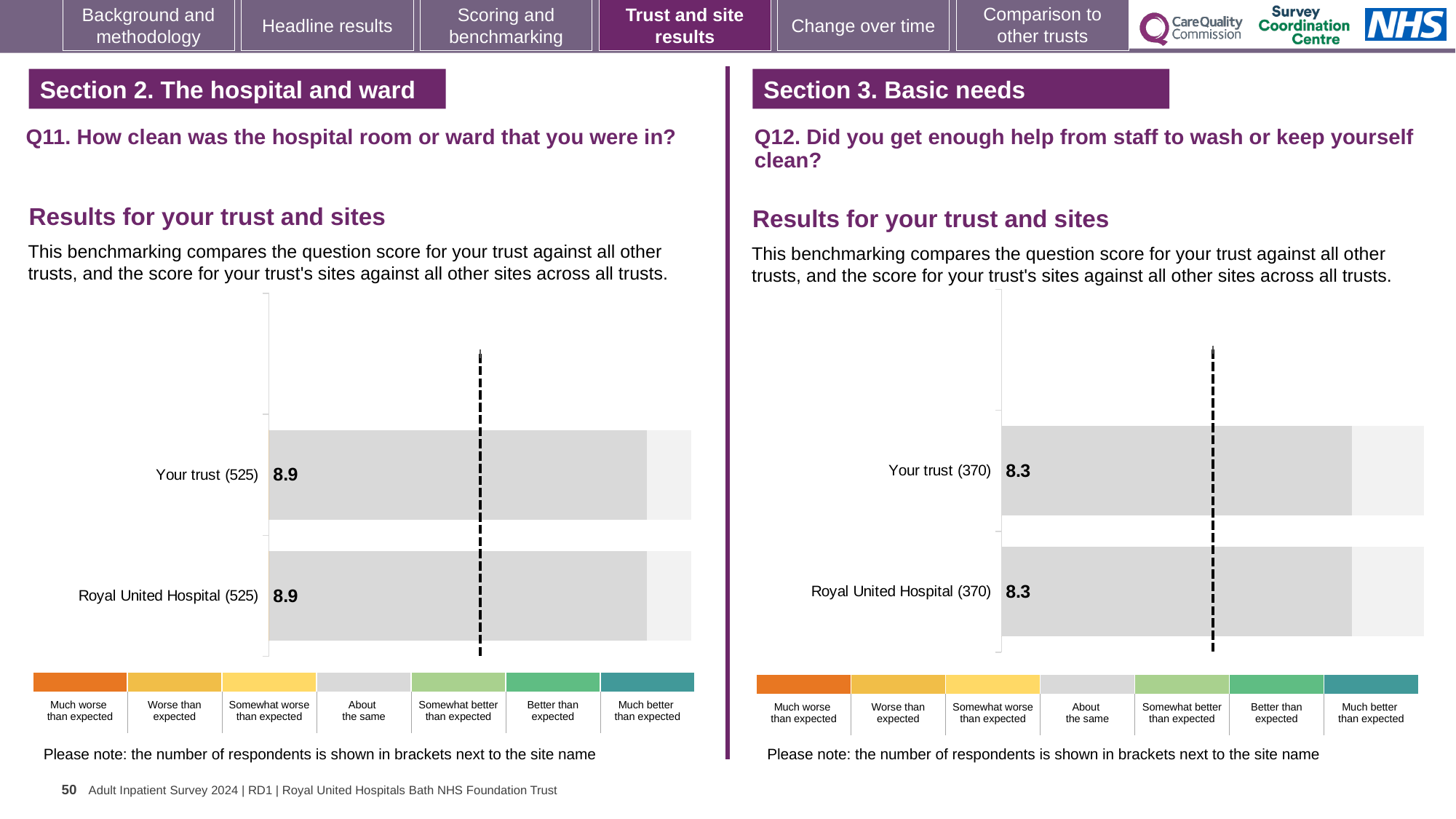
How many bars are plotted on the Q11 chart (left)? 2 On the Q12 chart (right), how many respondents are shown in brackets for Your trust? 370 What kind of chart is used on the Q11 chart (left)? Bar chart On the Q12 chart (right), what is the score for Your trust (370)? 8.3 On the Q12 chart (right), what is the score for Royal United Hospital (370)? 8.3 How many bars are plotted on the Q12 chart (right)? 2 On the Q11 chart (left), what is the difference between the score for Your trust and the score for Royal United Hospital? 0.0 On the Q11 chart (left), what is the score for Royal United Hospital (525)? 8.9 Is the score for Your trust on the Q11 chart (left) larger or smaller than the score for Your trust on the Q12 chart (right)? Larger On the Q11 chart (left), how many respondents are shown in brackets for Royal United Hospital? 525 On the Q12 chart (right), what is the difference between the score for Your trust and the score for Royal United Hospital? 0.0 On the Q11 chart (left), what is the score for Your trust (525)? 8.9